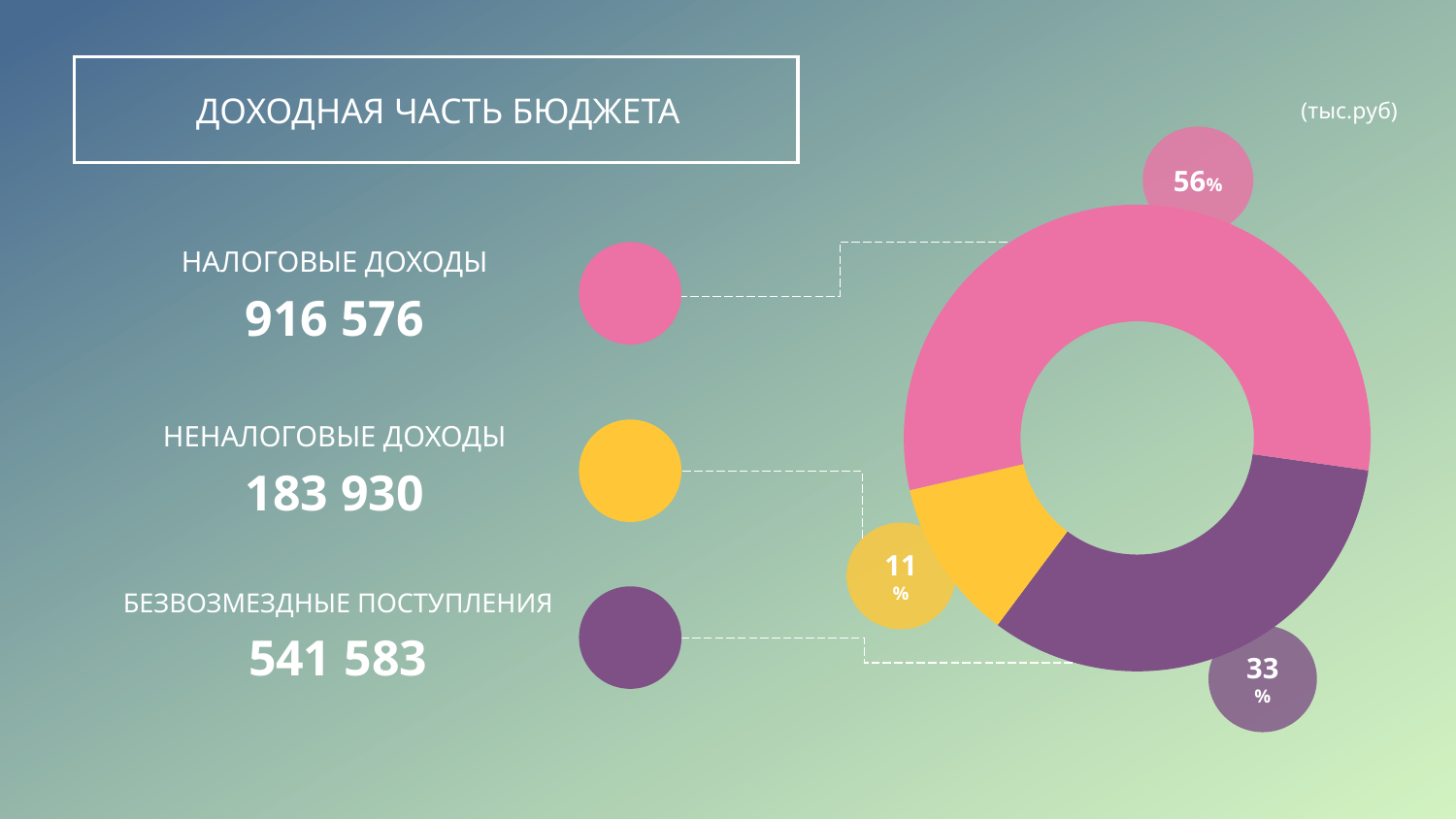
Which category has the largest share of the budget revenue? Налоговые доходы What kind of chart is shown on the slide? Donut (pie) chart What is the difference between Налоговые доходы and Неналоговые доходы? 732 646 Which category has the smallest share of the budget revenue? Неналоговые доходы Which is larger, Безвозмездные поступления or Неналоговые доходы? Безвозмездные поступления What is the title of the chart on the slide? ДОХОДНАЯ ЧАСТЬ БЮДЖЕТА What share of the donut chart does Налоговые доходы take? 56% What is the value for Безвозмездные поступления? 541 583 How many categories are shown in the donut chart? 3 What is the value for Неналоговые доходы? 183 930 What share of the donut chart does Безвозмездные поступления take? 33% What is the value for Налоговые доходы? 916 576